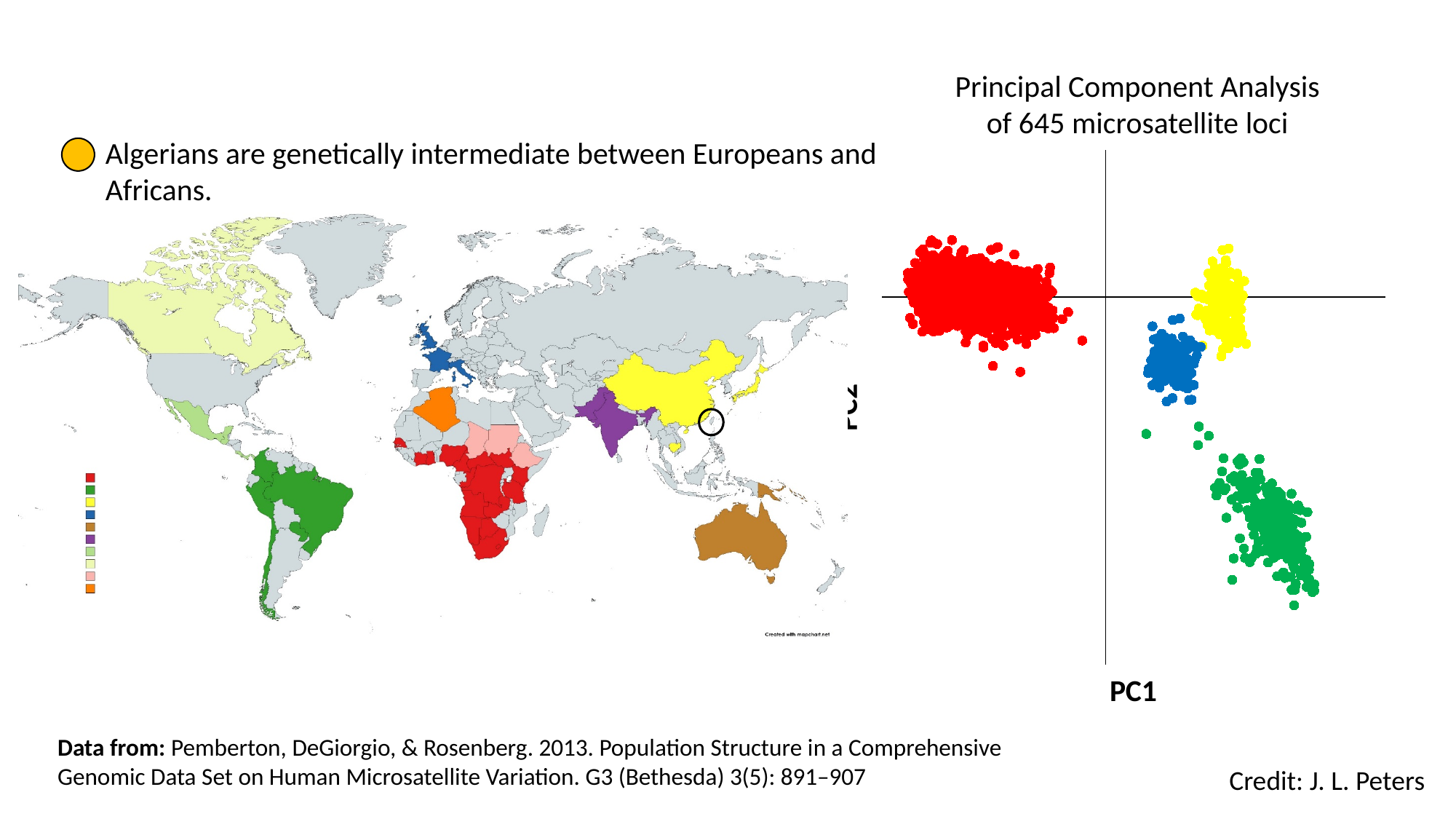
In the scatter plot, which cluster is positioned higher on the vertical axis, the yellow cluster or the blue cluster? yellow In the scatter plot, which coloured cluster extends lowest on the vertical axis? green In the scatter plot, which cluster lies further to the right along PC1, the green cluster or the blue cluster? green What is the label of the horizontal axis of the scatter plot? PC1 How many distinct coloured clusters of points are shown in the scatter plot? 4 What kind of chart is the 'Principal Component Analysis of 645 microsatellite loci' chart? scatter plot In the scatter plot, is the green cluster above or below the horizontal axis line? below In the scatter plot, which coloured cluster lies furthest to the left along PC1? red What is the title of the scatter plot on the right of the slide? Principal Component Analysis of 645 microsatellite loci